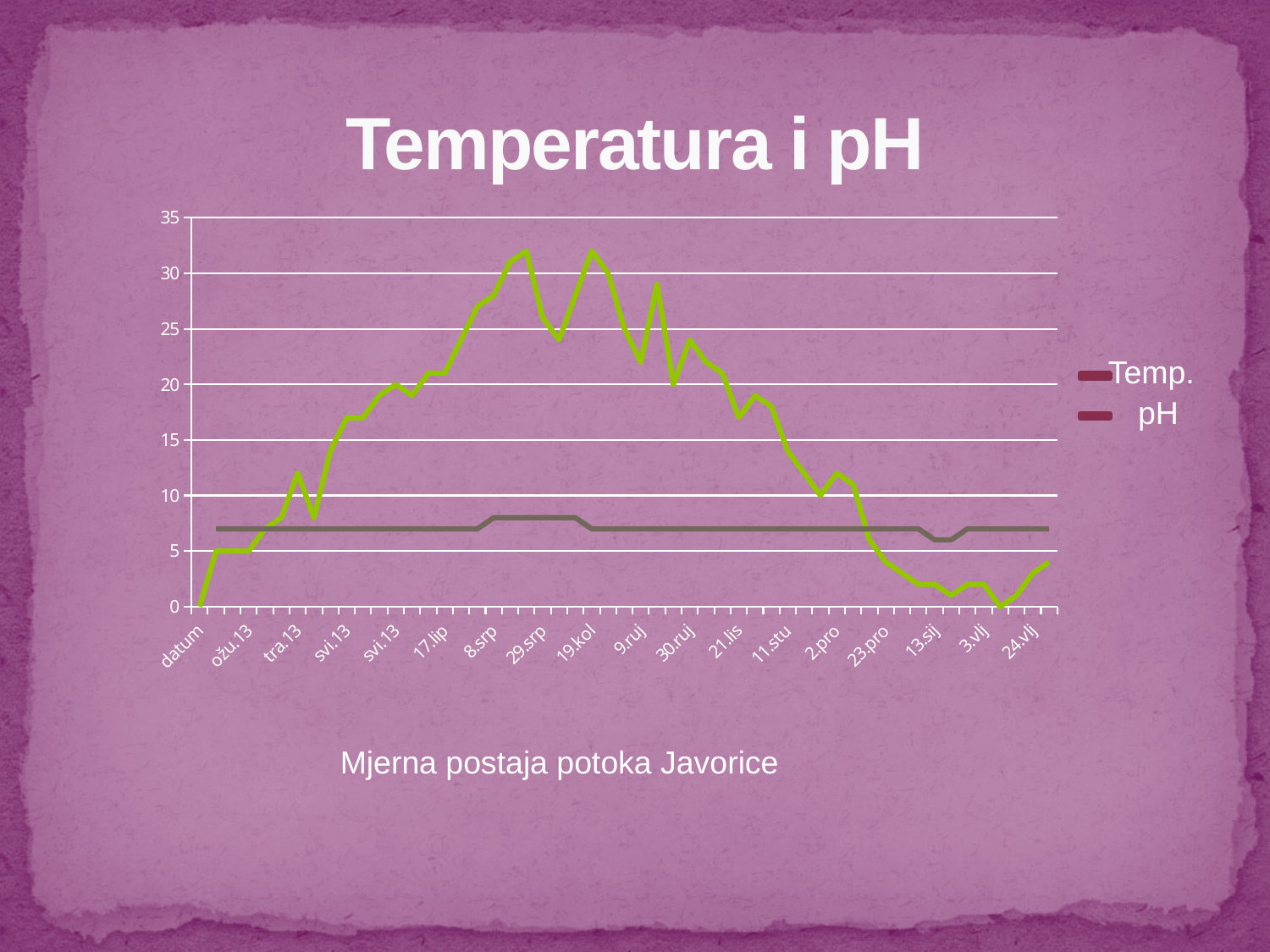
What kind of chart is shown on the slide? line chart Does the Temp. series rise or fall between 19.kol and 2.pro? fall Is the Temp. value at 8.srp greater or less than 20? greater Is the pH value at 8.srp greater or less than 5? greater How many series does the legend list? 2 Is the Temp. value at 19.kol greater or less than 25? greater What is the title of the chart? Temperatura i pH Which two series are listed in the legend? Temp. and pH Which series reaches the highest value on the chart, Temp. or pH? Temp. Which is larger, the Temp. value at 19.kol or the Temp. value at 13.sij? 19.kol